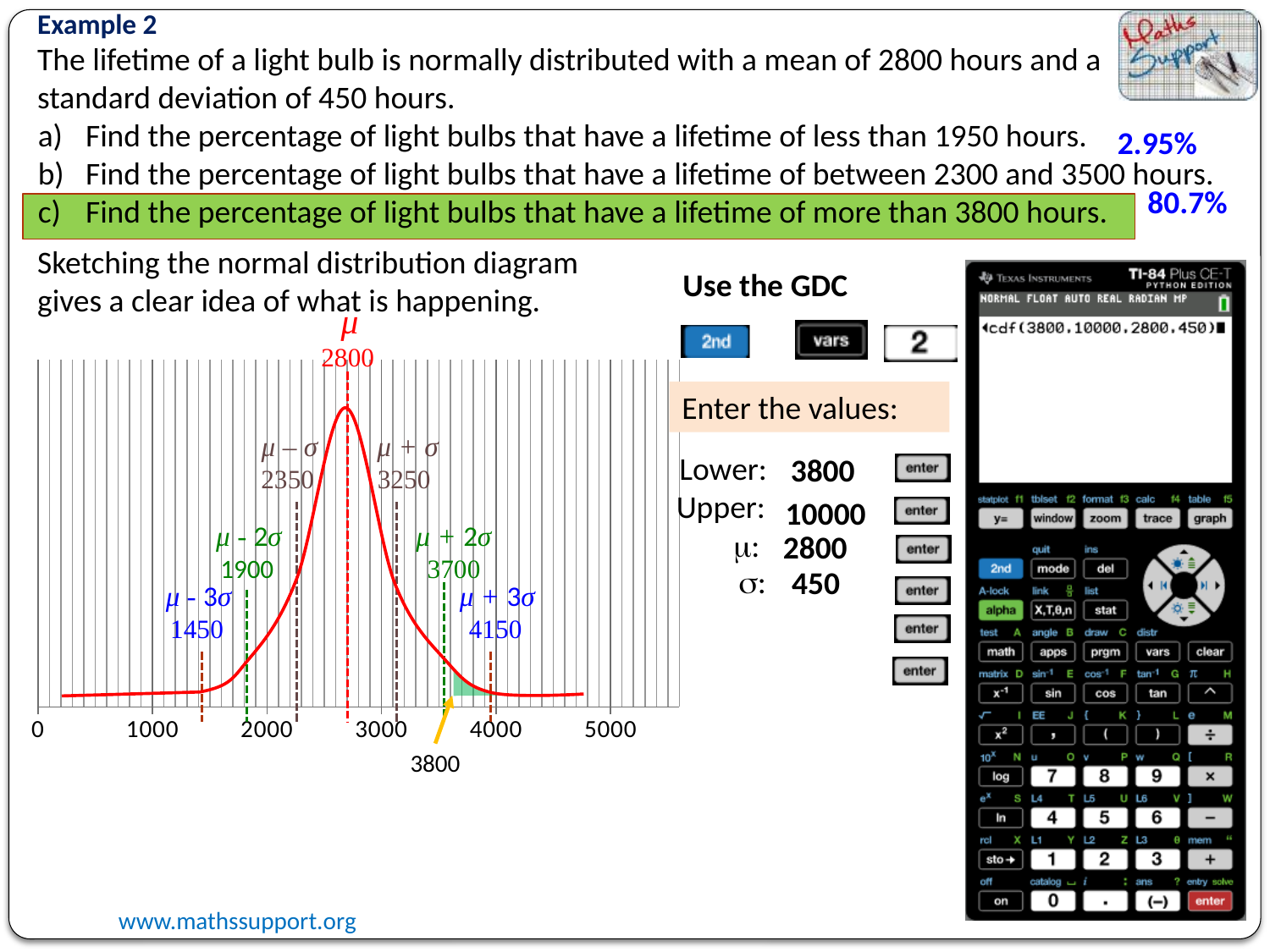
On the normal distribution diagram, what value is labelled at μ + 3σ? 4150 On the normal distribution diagram, is the value labelled at μ + 2σ greater or less than 4000? less What value does the yellow arrow point to on the normal distribution diagram? 3800 On the normal distribution diagram, what is the difference between the values labelled at μ + σ and μ − σ? 900 On the normal distribution diagram, does the curve rise or fall as x increases from 2800 to 4000? fall On the normal distribution diagram, what value is labelled at μ − 2σ? 1900 On the normal distribution diagram, which is larger: the value labelled at μ + 2σ or the value marked by the arrow? 3800 What kind of chart is the normal distribution diagram on the slide? line chart How many labelled tick values are shown on the x axis of the normal distribution diagram? 6 On the normal distribution diagram, what value is labelled at the mean μ? 2800 On the normal distribution diagram, what value is labelled at μ + σ? 3250 On the normal distribution diagram, what value is labelled at μ − 3σ? 1450